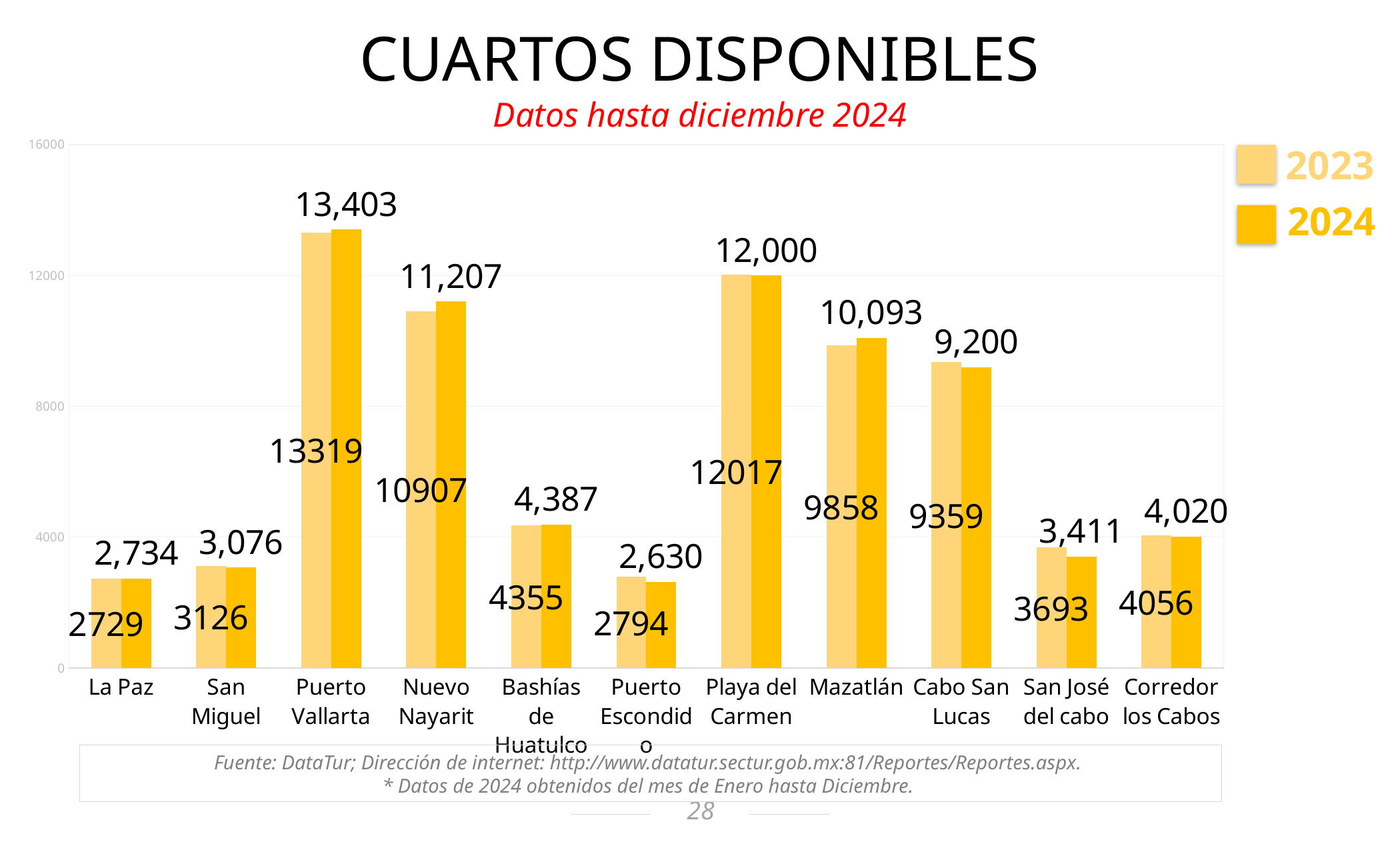
Is the 2024 value for Bashías de Huatulco greater or less than 4000? greater How many destinations (categories) are shown on the x axis? 11 What is the subtitle shown in red below the chart title? Datos hasta diciembre 2024 Which destination has the lowest number of available rooms in 2024? Puerto Escondido Which destination has the highest number of available rooms in 2024? Puerto Vallarta What is the difference between the 2024 and 2023 values for Nuevo Nayarit? 300 What is the 2023 value for Mazatlán? 9858 What is the 2024 value for San José del cabo? 3,411 For Cabo San Lucas, which year has the larger value, 2023 or 2024? 2023 What is the 2024 value for Puerto Vallarta? 13,403 What type of chart is shown on the slide? bar chart How many series does the legend list? 2